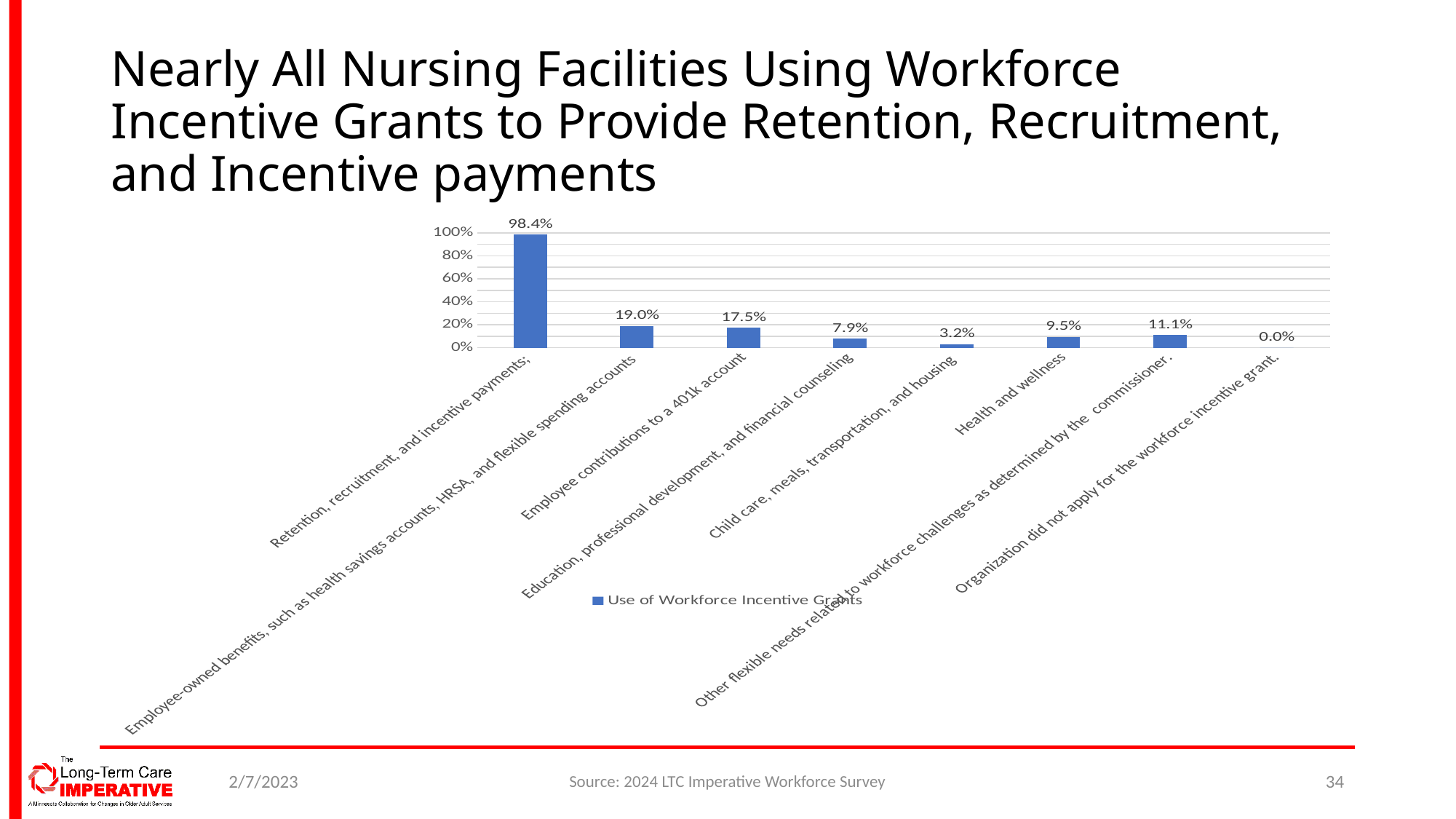
Which category has the highest value? Retention, recruitment, and incentive payments What is the value for Child care, meals, transportation, and housing? 3.2% Which is larger: the value for Health and wellness or the value for Education, professional development, and financial counseling? Health and wellness What is the value for Health and wellness? 9.5% What is the value for Organization did not apply for the workforce incentive grant? 0.0% What is the difference between the values for Employee-owned benefits (health savings accounts, HRSA, and flexible spending accounts) and Employee contributions to a 401k account? 1.5% What series name does the legend show? Use of Workforce Incentive Grants How many categories are shown in the chart? 8 Which category has the lowest value? Organization did not apply for the workforce incentive grant What is the value for Employee contributions to a 401k account? 17.5% What kind of chart is shown on the slide? Bar chart Is the value for Other flexible needs related to workforce challenges as determined by the commissioner greater or less than 20%? less